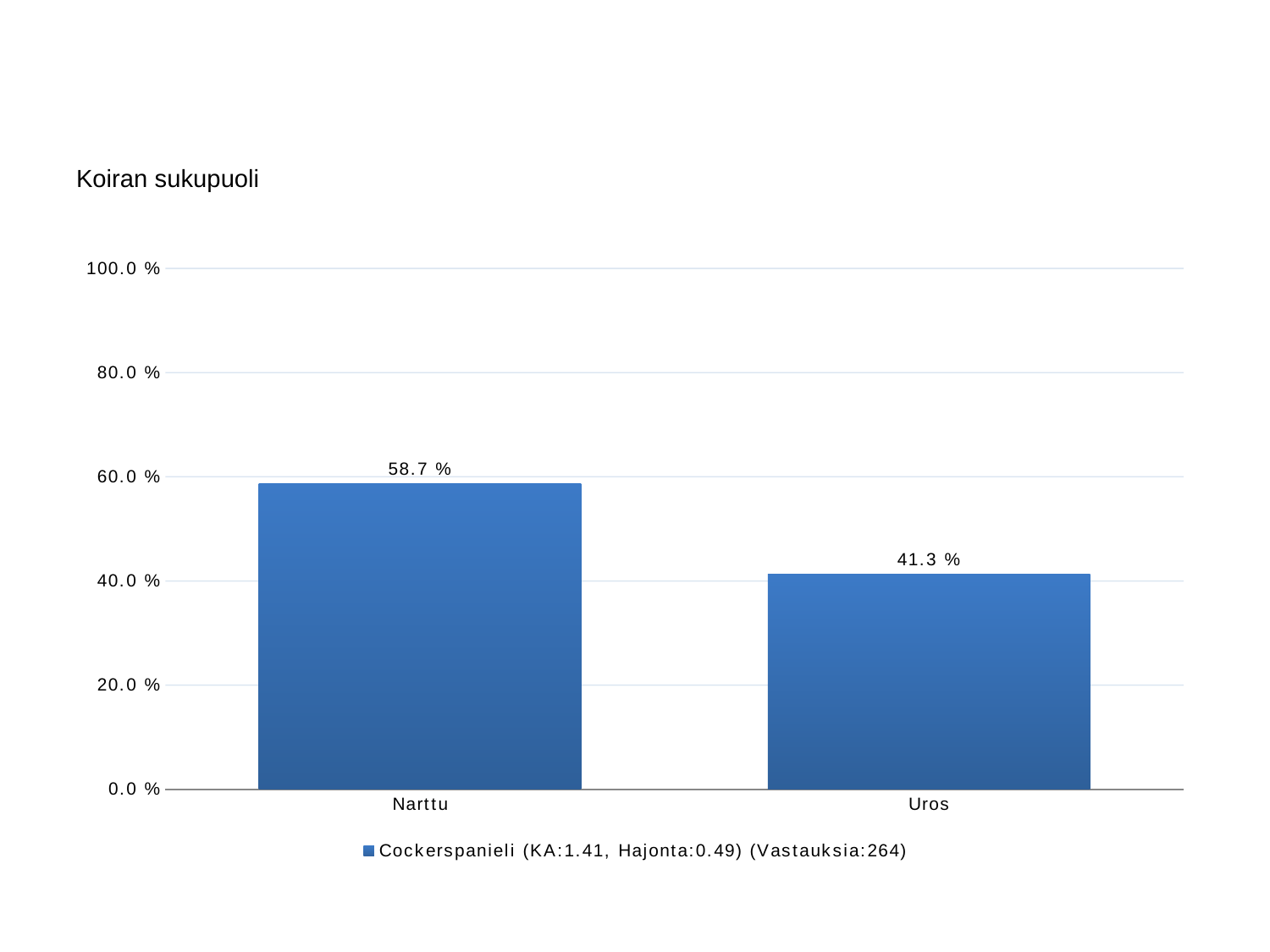
What is the difference between the values for Narttu and Uros? 17.4 % Is the value for Narttu greater or less than 40.0 %? greater What is the value for Uros? 41.3 % What is the title of the chart? Koiran sukupuoli Is the value for Uros greater or less than 60.0 %? less Which is larger, the value for Narttu or the value for Uros? Narttu Which category has the highest value? Narttu What is the value for Narttu? 58.7 % How many categories are shown on the x axis? 2 How many series does the legend list? 1 Which category has the lowest value? Uros What kind of chart is shown? bar chart